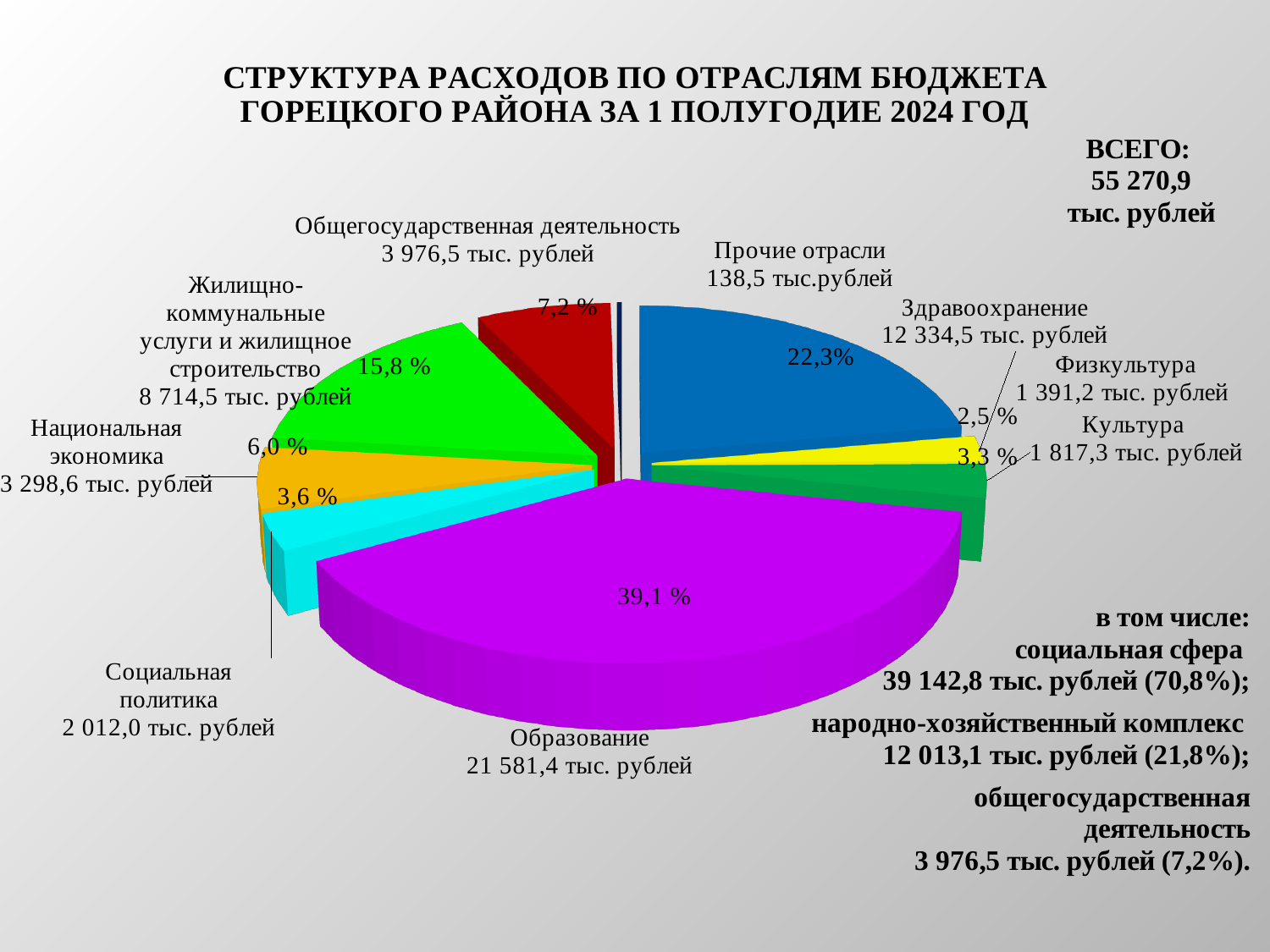
Which sector has the largest share of expenditures in the pie chart? Образование Which is larger: the expenditure for Национальная экономика or for Физкультура? Национальная экономика Which sector has the smallest share of expenditures in the pie chart? Прочие отрасли What share of the pie does Жилищно-коммунальные услуги и жилищное строительство represent? 15,8 % What is the difference between the expenditures for Образование and Здравоохранение? 9 246,9 тыс. рублей What is the expenditure value for Социальная политика? 2 012,0 тыс. рублей What total expenditure (ВСЕГО) is stated on the slide? 55 270,9 тыс. рублей How many sectors are shown in the pie chart? 9 What is the expenditure value for Здравоохранение? 12 334,5 тыс. рублей What share of the pie does Культура represent? 3,3 % What kind of chart is shown on the slide? Pie chart What is the expenditure value for Образование? 21 581,4 тыс. рублей